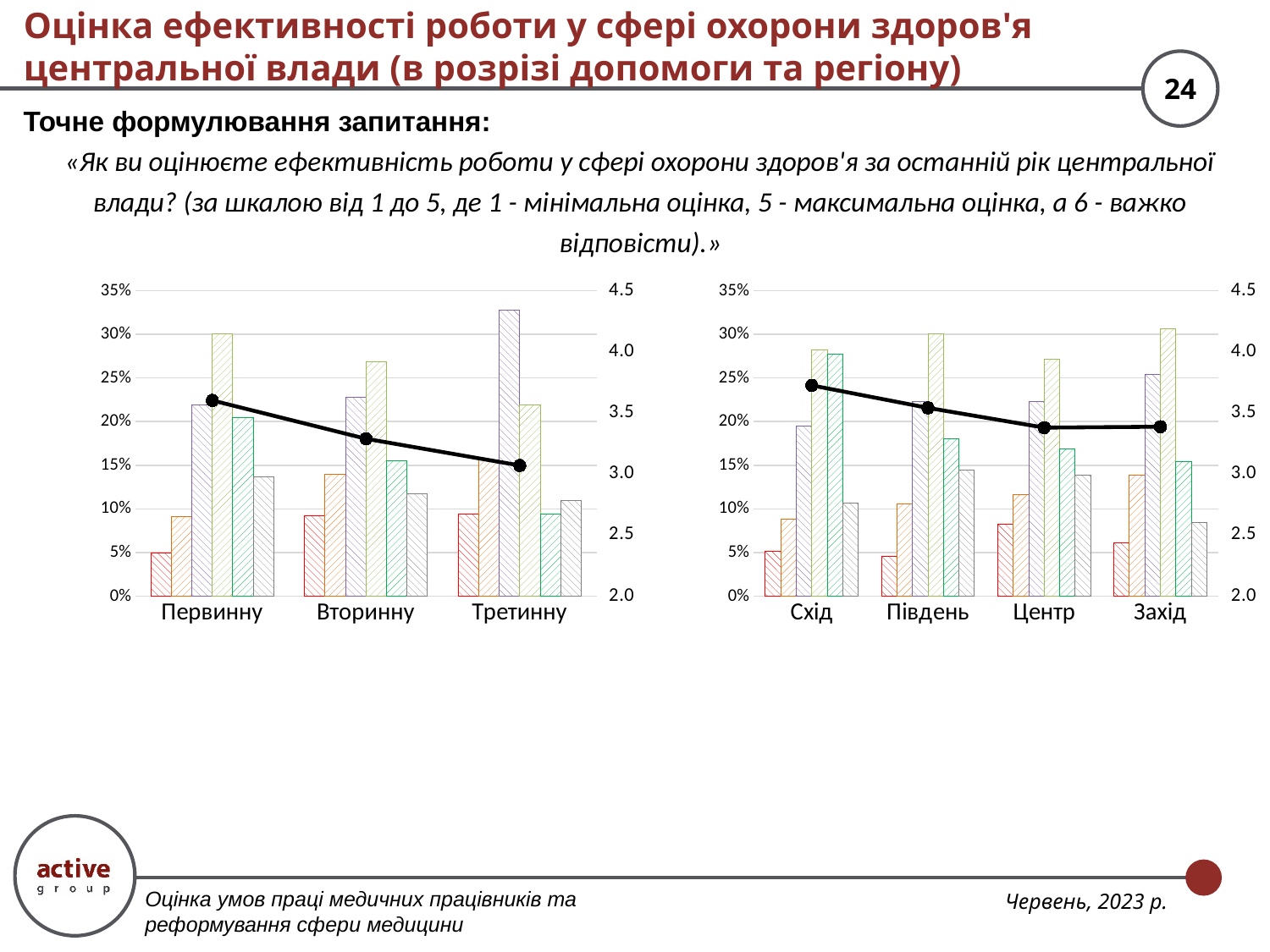
On the left chart, what is the range of the right-hand vertical axis? 2.0 to 4.5 On the left chart, does the black line rise or fall from Первинну to Третинну? Fall On the right chart, which category has the highest black line value? Схід On the left chart, how many categories are shown on the x axis? 3 On the right chart, is the black line value for Центр greater or less than 3.5? less On the right chart, is the tallest bar for Схід greater or less than 25%? greater On the right chart, is the black line value for Схід greater or less than 3.5? greater On the right chart, does the black line rise or fall from Схід to Захід? Fall On the right chart, how many categories are shown on the x axis? 4 What kind of chart is the left chart? Bar chart with a line